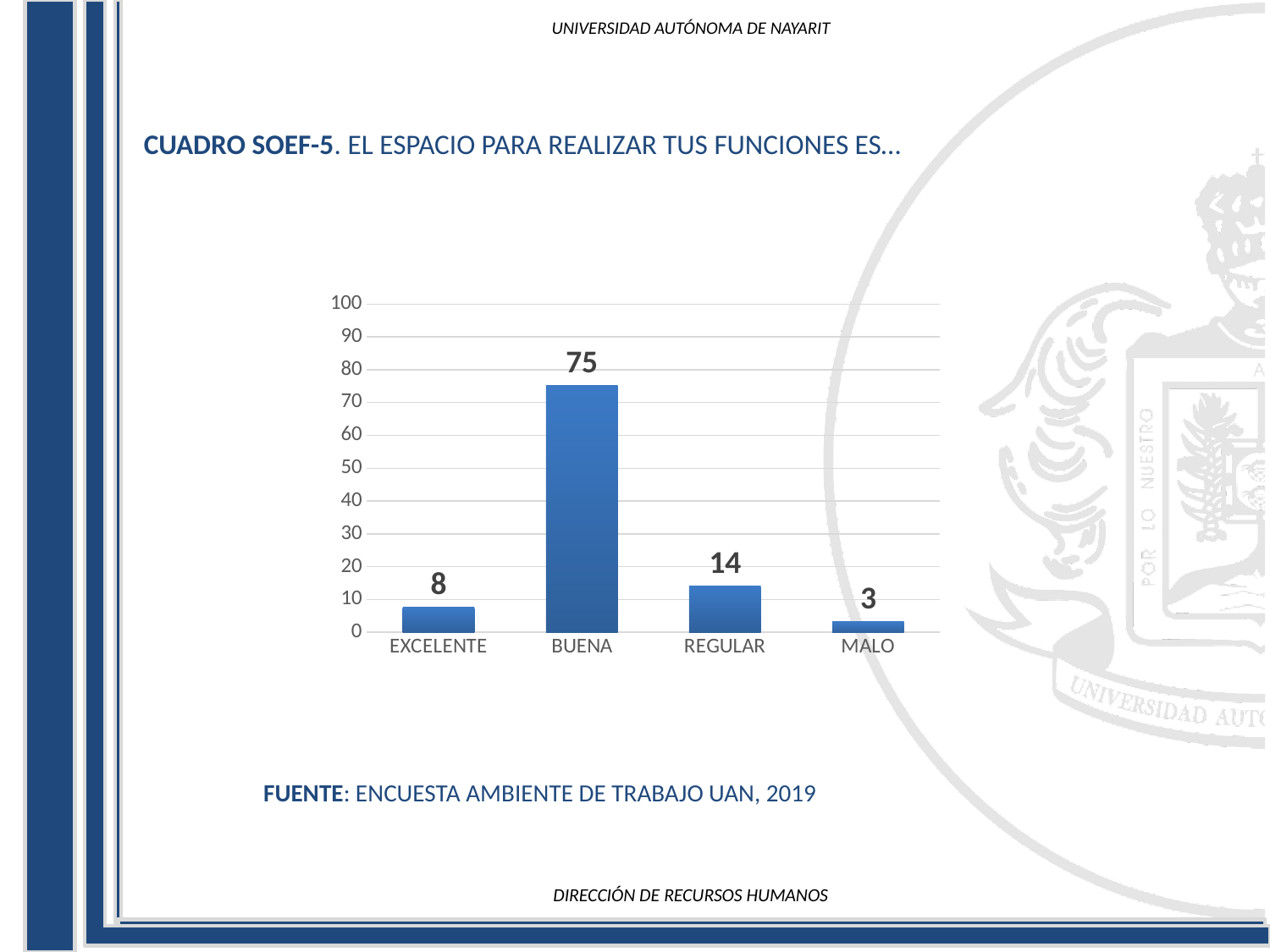
What is the difference between the values for REGULAR and EXCELENTE? 6 How many categories are shown on the x axis? 4 What is the value for REGULAR? 14 Which category has the lowest value? MALO What is the value for BUENA? 75 What is the value for MALO? 3 What kind of chart is shown on the slide? Bar chart Which category has the highest value? BUENA Is the value for BUENA greater or less than 70? greater Which is larger, the value for EXCELENTE or the value for REGULAR? REGULAR What is the value for EXCELENTE? 8 What is the difference between the values for BUENA and REGULAR? 61